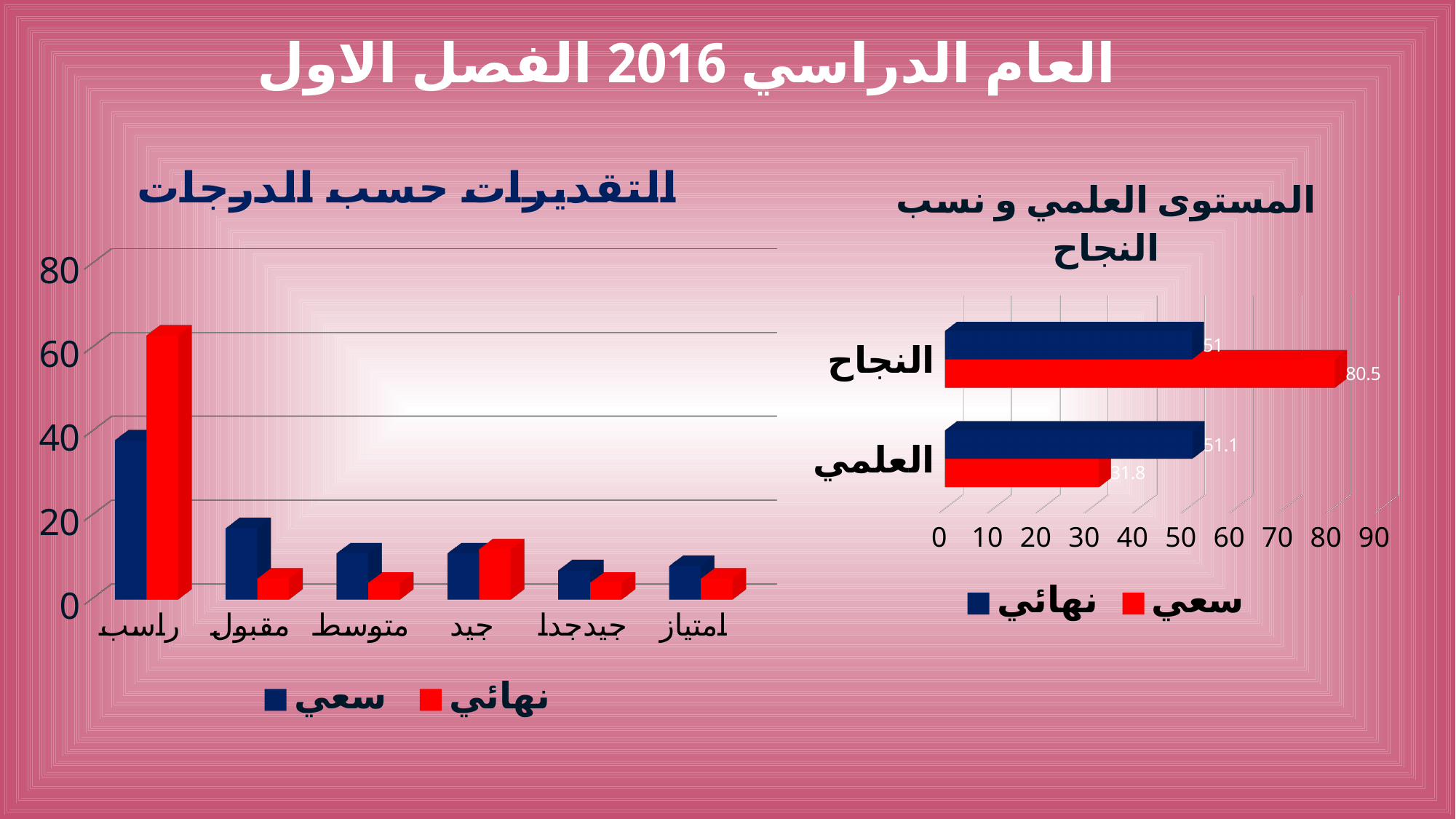
What kind of chart is the chart titled "التقديرات حسب الدرجات"? bar chart In the chart titled "المستوى العلمي و نسب النجاح", which category has the higher سعي value, النجاح or العلمي? النجاح In the chart titled "التقديرات حسب الدرجات", is the نهائي value for راسب greater or less than 60? greater In the chart titled "المستوى العلمي و نسب النجاح", what is the value of سعي for النجاح? 80.5 In the chart titled "المستوى العلمي و نسب النجاح", how many categories are shown? 2 In the chart titled "المستوى العلمي و نسب النجاح", what is the value of سعي for العلمي? 31.8 In the chart titled "المستوى العلمي و نسب النجاح", what is the value of نهائي for العلمي? 51.1 In the chart titled "المستوى العلمي و نسب النجاح", what is the difference between the سعي values for النجاح and العلمي? 48.7 In the chart titled "التقديرات حسب الدرجات", is the سعي value for مقبول greater or less than 20? less In the chart titled "التقديرات حسب الدرجات", how many categories are shown on the x axis? 6 In the chart titled "التقديرات حسب الدرجات", how many series does the legend list? 2 In the chart titled "التقديرات حسب الدرجات", which category has the highest نهائي value? راسب